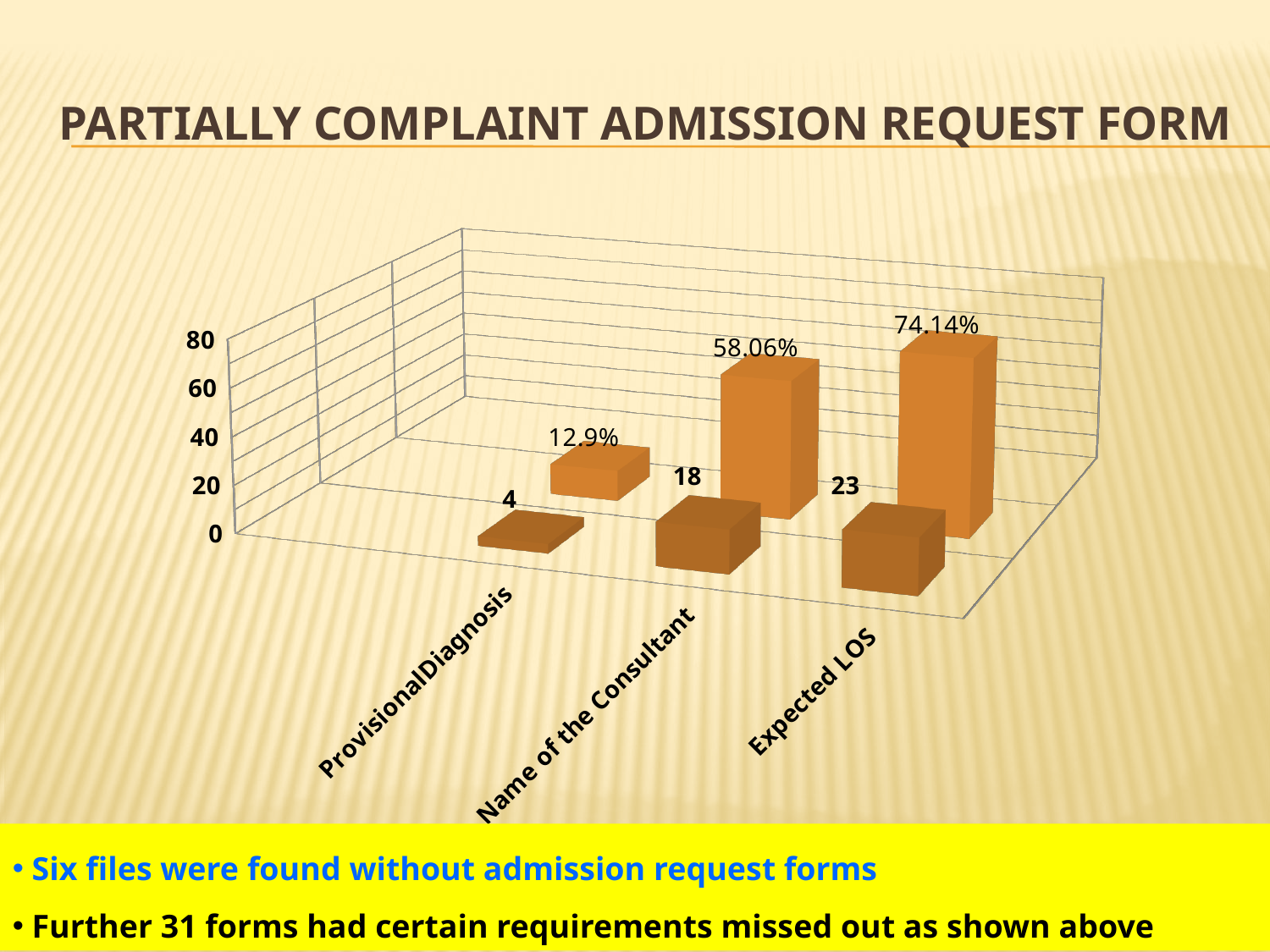
What kind of chart is shown on the slide? Bar chart Do the values rise or fall from ProvisionalDiagnosis to Expected LOS? Rise What count is shown for Name of the Consultant? 18 What percentage is shown for ProvisionalDiagnosis? 12.9% What is the difference between the percentages for Expected LOS and Name of the Consultant? 16.08% What is the difference between the counts for Expected LOS and ProvisionalDiagnosis? 19 Which has the larger count, Name of the Consultant or ProvisionalDiagnosis? Name of the Consultant Which category has the highest percentage? Expected LOS What percentage is shown for Expected LOS? 74.14% Which category has the lowest count? ProvisionalDiagnosis What count is shown for Expected LOS? 23 How many categories are shown on the x axis? 3